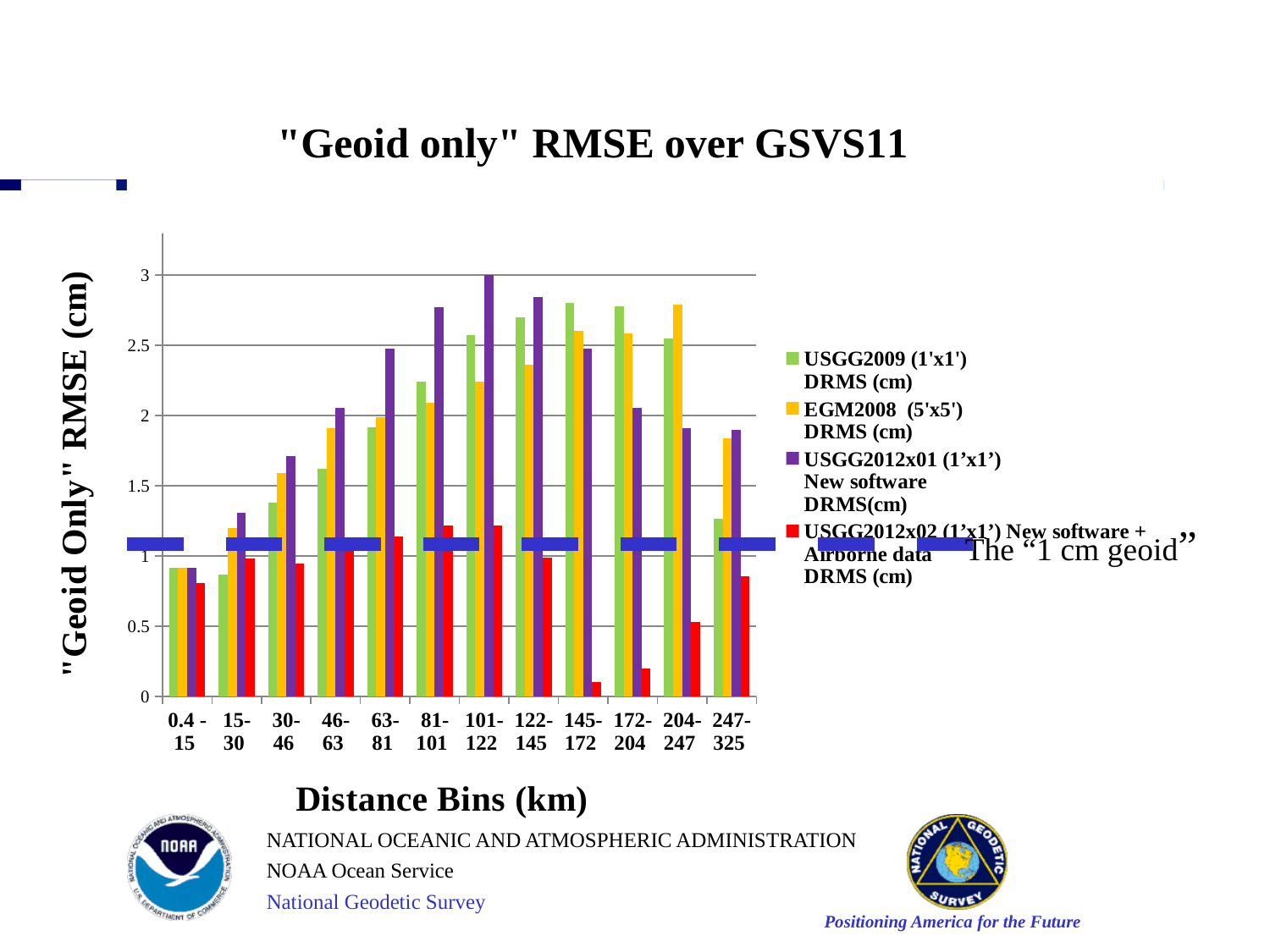
What kind of chart is shown on the slide? bar chart How many series does the legend list? 4 In which distance bin is the USGG2012x01 (1'x1') New software DRMS value highest? 101-122 Is the USGG2012x01 (1'x1') New software DRMS value for the 101-122 km bin greater or less than 2.5? greater How many distance bins are shown on the x axis? 12 For the 101-122 km bin, which is larger: the USGG2012x01 (1'x1') New software DRMS value or the USGG2012x02 (1'x1') New software + Airborne data DRMS value? USGG2012x01 (1'x1') New software DRMS In which distance bin is the USGG2012x02 (1'x1') New software + Airborne data DRMS value lowest? 145-172 Is the EGM2008 (5'x5') DRMS value for the 204-247 km bin greater or less than 2.5? greater Is the USGG2012x02 (1'x1') New software + Airborne data DRMS value for the 145-172 km bin greater or less than 0.5? less What is the label of the x axis? Distance Bins (km) What is the title of the chart? "Geoid only" RMSE over GSVS11